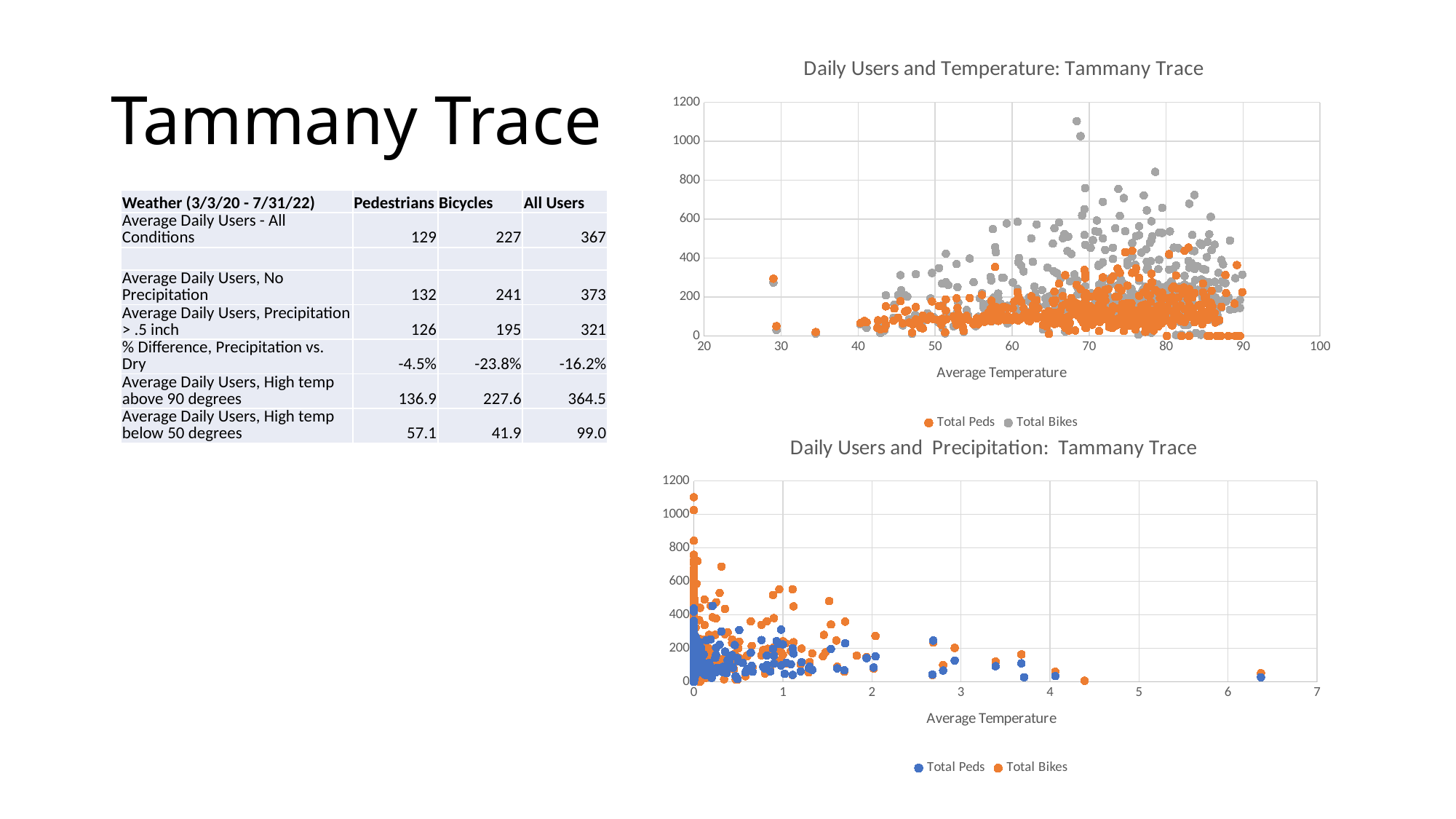
In the 'Daily Users and Precipitation: Tammany Trace' chart, are the values plotted at x greater than 4 greater or less than 200? less How many series does the legend of the 'Daily Users and Precipitation: Tammany Trace' chart list? 2 What kind of chart is the 'Daily Users and Precipitation: Tammany Trace' chart? scatter chart What is the title of the lower chart on the slide? Daily Users and Precipitation: Tammany Trace How many series does the legend of the 'Daily Users and Temperature: Tammany Trace' chart list? 2 In the 'Daily Users and Precipitation: Tammany Trace' chart, is the highest Total Bikes value greater or less than 1000? greater In the 'Daily Users and Precipitation: Tammany Trace' chart, which series reaches the highest value, Total Peds or Total Bikes? Total Bikes In the 'Daily Users and Temperature: Tammany Trace' chart, which series reaches the highest value, Total Peds or Total Bikes? Total Bikes What kind of chart is the 'Daily Users and Temperature: Tammany Trace' chart? scatter chart In the 'Daily Users and Temperature: Tammany Trace' chart, is the highest Total Bikes value greater or less than 1000? greater In the 'Daily Users and Temperature: Tammany Trace' chart, do the Total Bikes values generally rise or fall as average temperature increases from 40 to 80? rise What are the legend entries of the 'Daily Users and Temperature: Tammany Trace' chart? Total Peds, Total Bikes